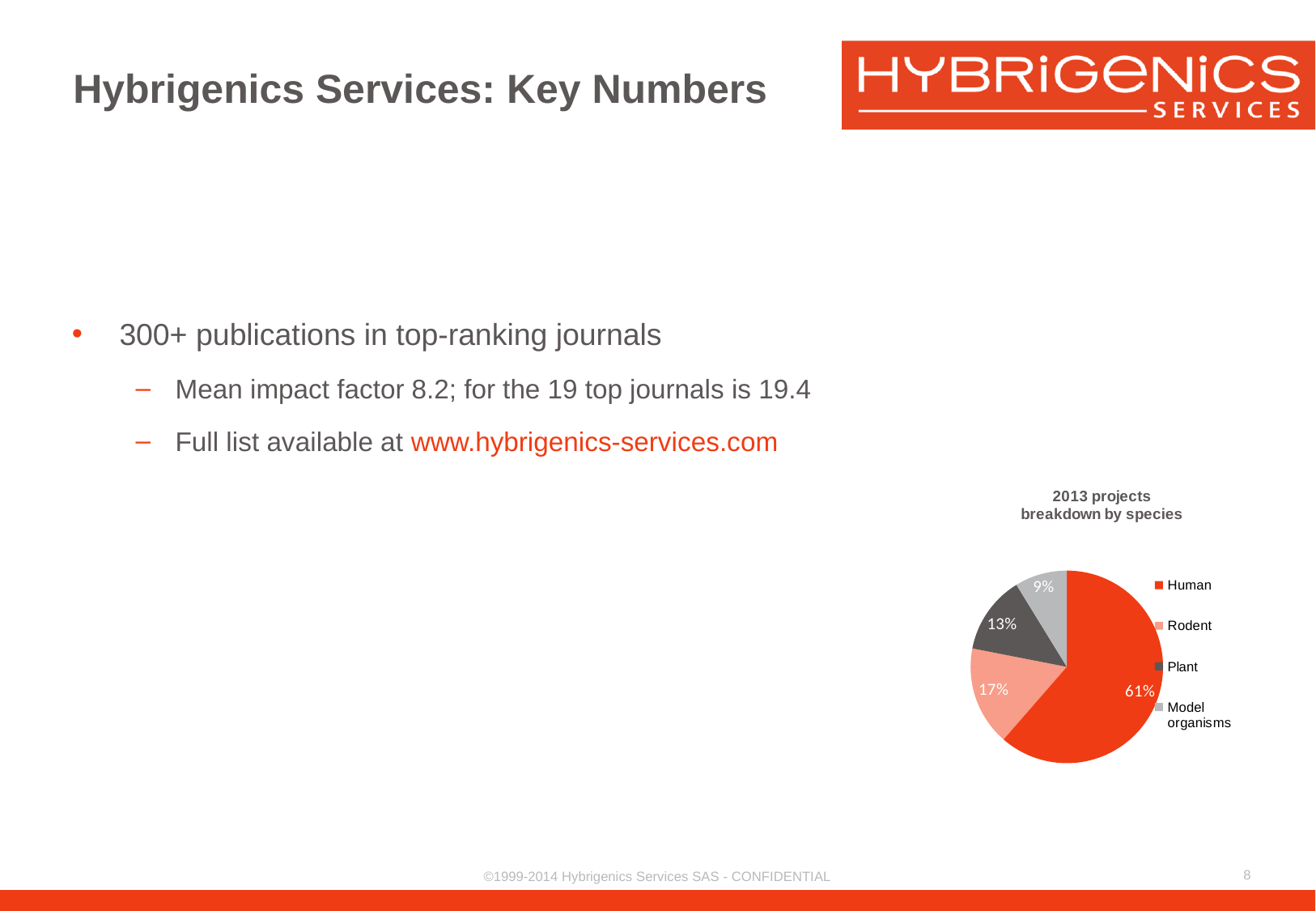
Which has a larger share of 2013 projects, Plant or Model organisms? Plant What share of 2013 projects were Plant? 13% What is the difference in percentage points between the Human and Rodent shares? 44 What kind of chart is shown on the slide? pie chart What share of 2013 projects were Rodent? 17% What share of 2013 projects were Model organisms? 9% Which species has the largest share of 2013 projects? Human Which species has the smallest share of 2013 projects? Model organisms What share of 2013 projects were Human? 61% What colour represents Human in the pie chart? red-orange What is the title of the chart? 2013 projects breakdown by species How many species categories does the pie chart show? 4